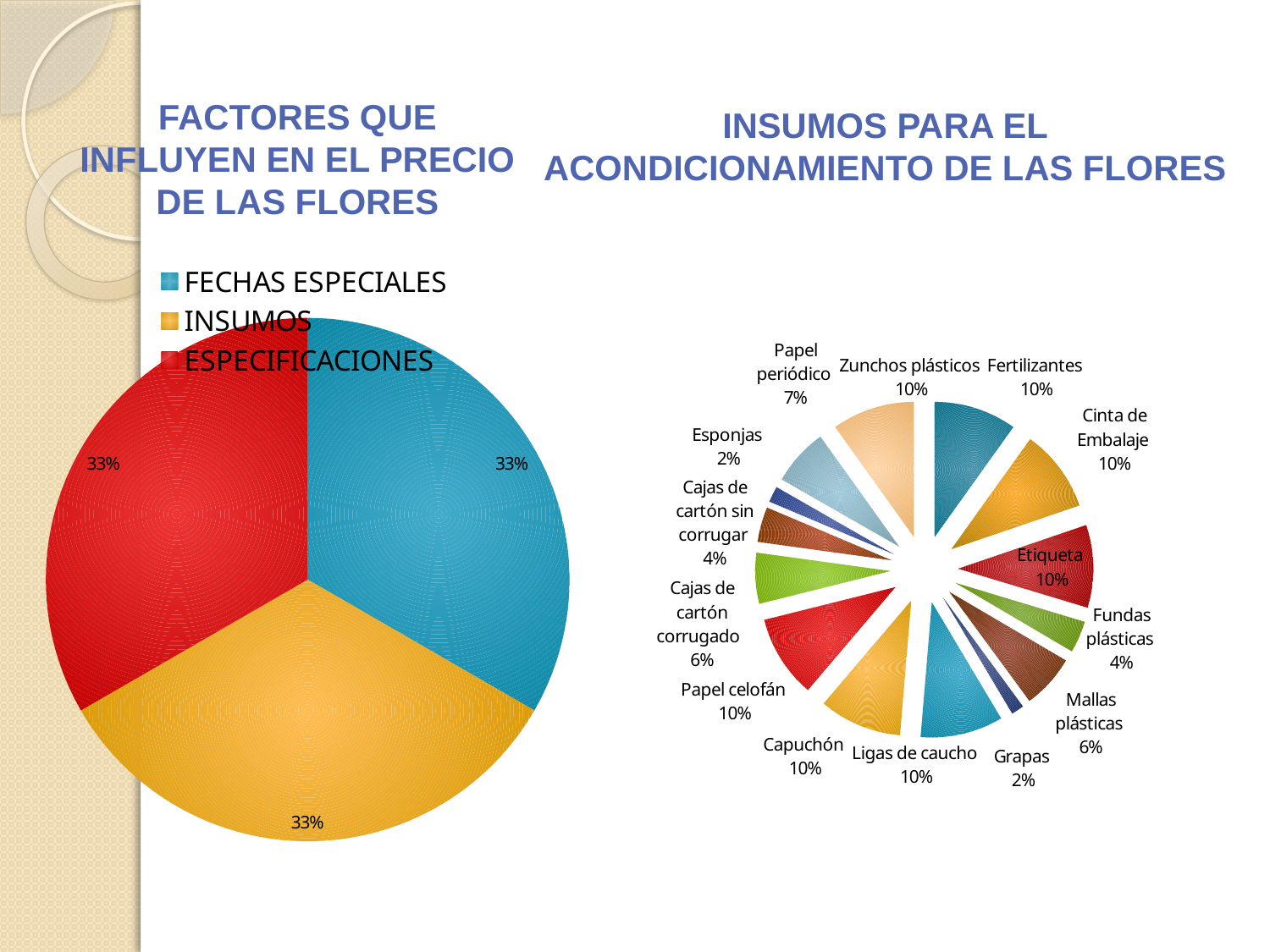
In the chart titled 'FACTORES QUE INFLUYEN EN EL PRECIO DE LAS FLORES', which colour represents ESPECIFICACIONES? red In the chart titled 'INSUMOS PARA EL ACONDICIONAMIENTO DE LAS FLORES', what is the value for Mallas plásticas? 6% In the chart titled 'FACTORES QUE INFLUYEN EN EL PRECIO DE LAS FLORES', what share does INSUMOS have? 33% What kind of chart is the chart titled 'INSUMOS PARA EL ACONDICIONAMIENTO DE LAS FLORES'? pie chart In the chart titled 'INSUMOS PARA EL ACONDICIONAMIENTO DE LAS FLORES', what is the difference between Papel periódico and Mallas plásticas? 1% In the chart titled 'INSUMOS PARA EL ACONDICIONAMIENTO DE LAS FLORES', what is the value for Grapas? 2% How many entries does the legend of the chart titled 'FACTORES QUE INFLUYEN EN EL PRECIO DE LAS FLORES' list? 3 In the chart titled 'INSUMOS PARA EL ACONDICIONAMIENTO DE LAS FLORES', what is the value for Papel periódico? 7% How many slices does the chart titled 'INSUMOS PARA EL ACONDICIONAMIENTO DE LAS FLORES' have? 14 In the chart titled 'INSUMOS PARA EL ACONDICIONAMIENTO DE LAS FLORES', what is the value for Cajas de cartón sin corrugar? 4% In the chart titled 'INSUMOS PARA EL ACONDICIONAMIENTO DE LAS FLORES', which is larger, Cajas de cartón corrugado or Fundas plásticas? Cajas de cartón corrugado What kind of chart is the chart titled 'FACTORES QUE INFLUYEN EN EL PRECIO DE LAS FLORES'? pie chart